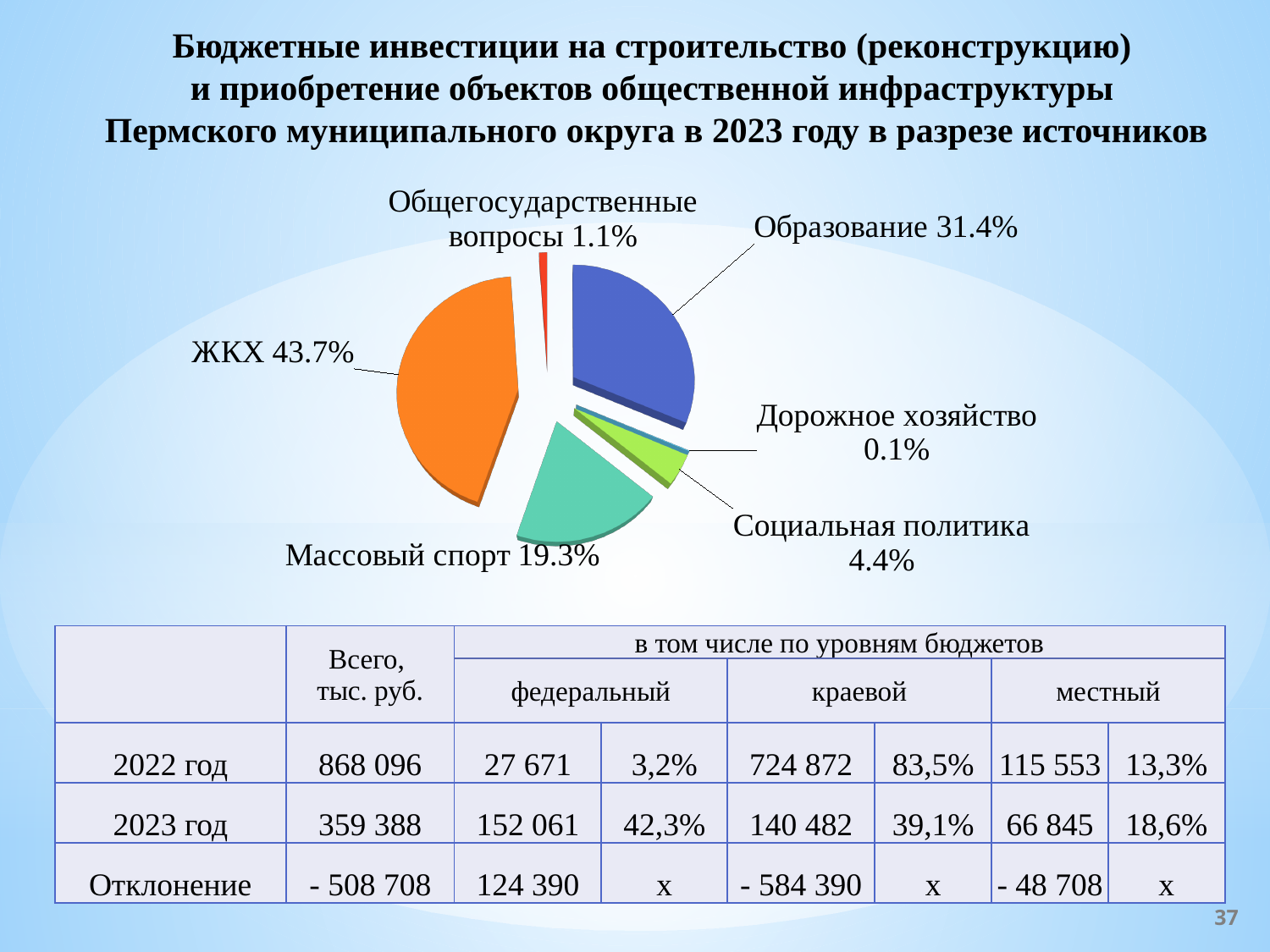
What share of the pie chart does Образование account for? 31.4% Which category has the smallest slice in the pie chart? Дорожное хозяйство How many slices does the pie chart have? 6 What is the value shown for Общегосударственные вопросы in the pie chart? 1.1% What is the difference in percentage points between ЖКХ and Образование in the pie chart? 12.3 Which is larger in the pie chart: Массовый спорт or Социальная политика? Массовый спорт What is the value shown for Социальная политика in the pie chart? 4.4% What share of the pie chart does ЖКХ account for? 43.7% Which category has the largest slice in the pie chart? ЖКХ What colour is the ЖКХ slice in the pie chart? Orange What type of chart is shown on the slide? Pie chart What is the value shown for Массовый спорт in the pie chart? 19.3%